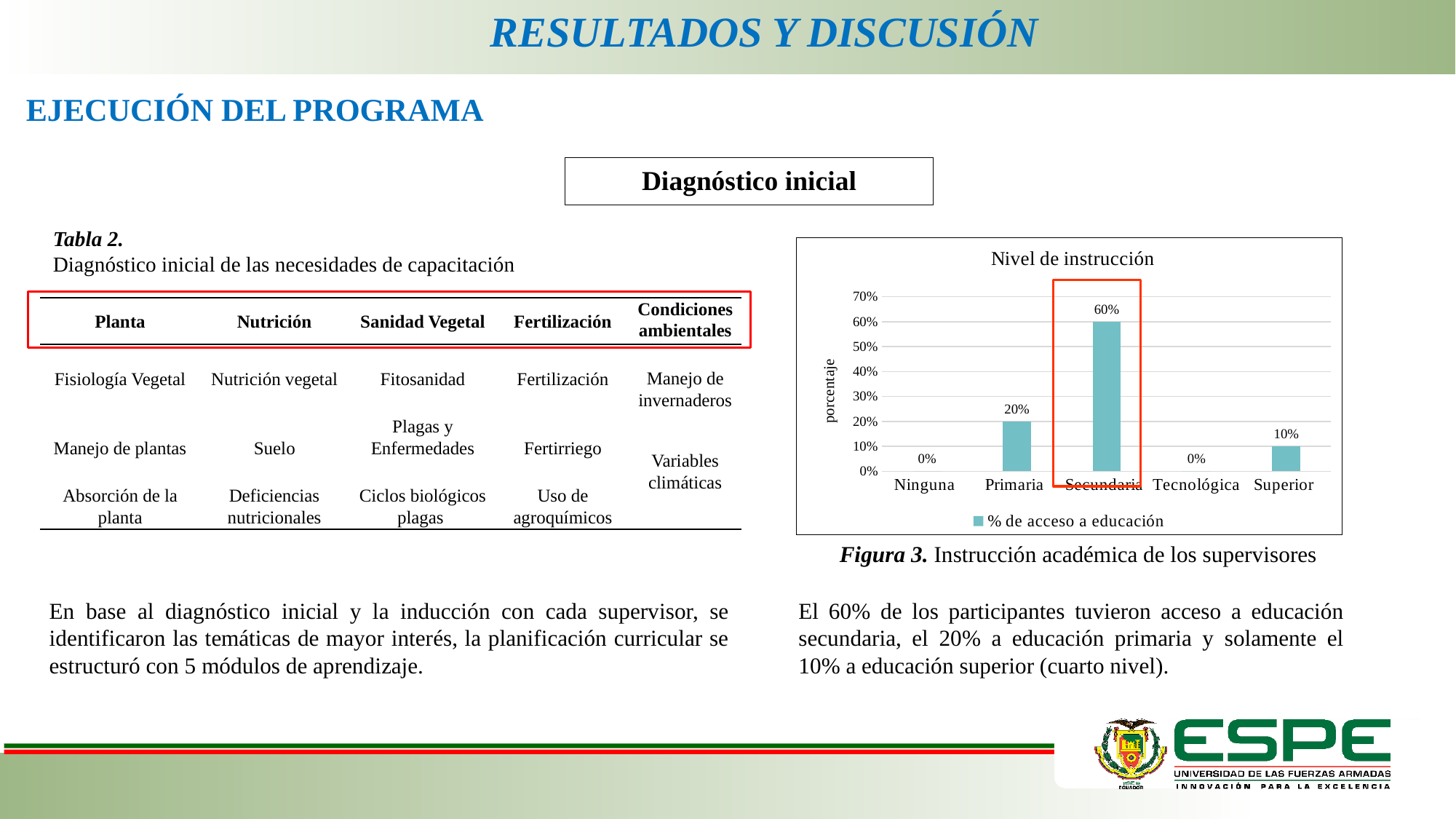
How many categories are shown on the x axis of the 'Nivel de instrucción' chart? 5 What is the value for Superior in the 'Nivel de instrucción' chart? 10% What is the difference between the values for Secundaria and Primaria in the 'Nivel de instrucción' chart? 40% What is the value for Primaria in the 'Nivel de instrucción' chart? 20% What is the value for Secundaria in the 'Nivel de instrucción' chart? 60% How many series does the legend of the 'Nivel de instrucción' chart list? 1 Which category has the highest value in the 'Nivel de instrucción' chart? Secundaria What is the legend entry of the 'Nivel de instrucción' chart? % de acceso a educación Which is larger in the 'Nivel de instrucción' chart, Primaria or Superior? Primaria What kind of chart is the 'Nivel de instrucción' chart? Bar chart What is the value for Tecnológica in the 'Nivel de instrucción' chart? 0% Is the value for Secundaria in the 'Nivel de instrucción' chart greater or less than 50%? greater